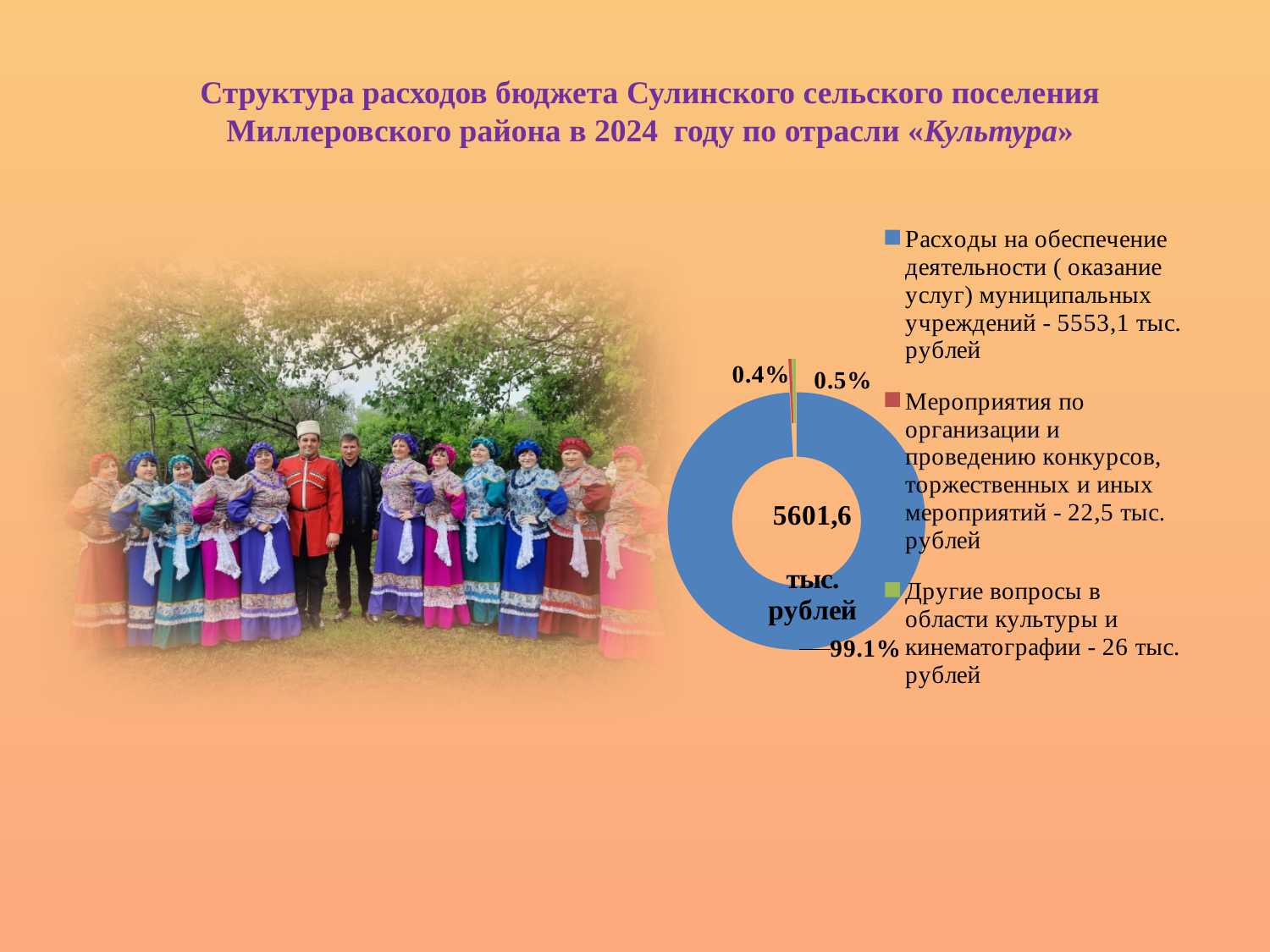
What kind of chart is shown on the slide? doughnut (pie) chart According to the legend, what amount in thousand rubles is spent on 'Мероприятия по организации и проведению конкурсов, торжественных и иных мероприятий'? 22,5 тыс. рублей Which category has the smallest share of the chart? Мероприятия по организации и проведению конкурсов, торжественных и иных мероприятий Which category has the largest share of the chart? Расходы на обеспечение деятельности (оказание услуг) муниципальных учреждений According to the legend, what amount in thousand rubles is spent on 'Другие вопросы в области культуры и кинематографии'? 26 тыс. рублей How many categories does the chart's legend list? 3 What percentage share is shown for 'Расходы на обеспечение деятельности (оказание услуг) муниципальных учреждений'? 99.1% What colour is the slice representing 'Расходы на обеспечение деятельности (оказание услуг) муниципальных учреждений'? blue What percentage share is shown for 'Мероприятия по организации и проведению конкурсов, торжественных и иных мероприятий'? 0.4% What total amount is printed in the centre of the doughnut chart? 5601,6 тыс. рублей Which is larger: the share for 'Другие вопросы в области культуры и кинематографии' or the share for 'Мероприятия по организации и проведению конкурсов'? Другие вопросы в области культуры и кинематографии What percentage share is shown for 'Другие вопросы в области культуры и кинематографии'? 0.5%